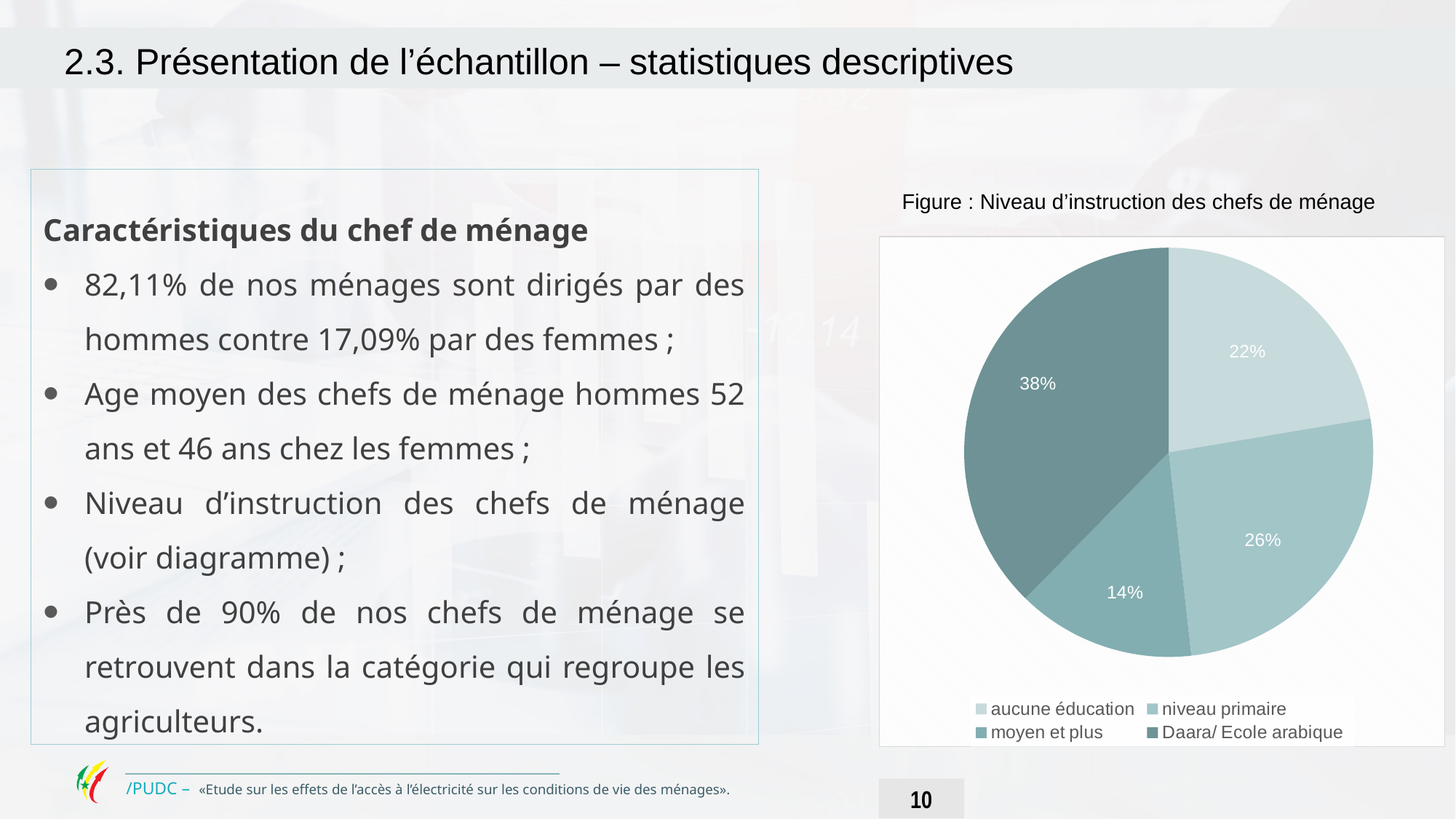
What share of the pie does 'niveau primaire' represent? 26% What share of the pie does 'Daara/ Ecole arabique' represent? 38% Which is larger, the share for 'niveau primaire' or the share for 'aucune éducation'? niveau primaire What share of the pie does 'moyen et plus' represent? 14% What is the difference in percentage points between 'Daara/ Ecole arabique' and 'aucune éducation'? 16 What is the title of the figure on the slide? Figure : Niveau d'instruction des chefs de ménage What share of the pie does 'aucune éducation' represent? 22% What is the combined share of 'aucune éducation' and 'niveau primaire'? 48% How many categories does the pie chart show? 4 Which category has the smallest share of the pie? moyen et plus What kind of chart is shown on the slide? pie chart Which category has the largest share of the pie? Daara/ Ecole arabique